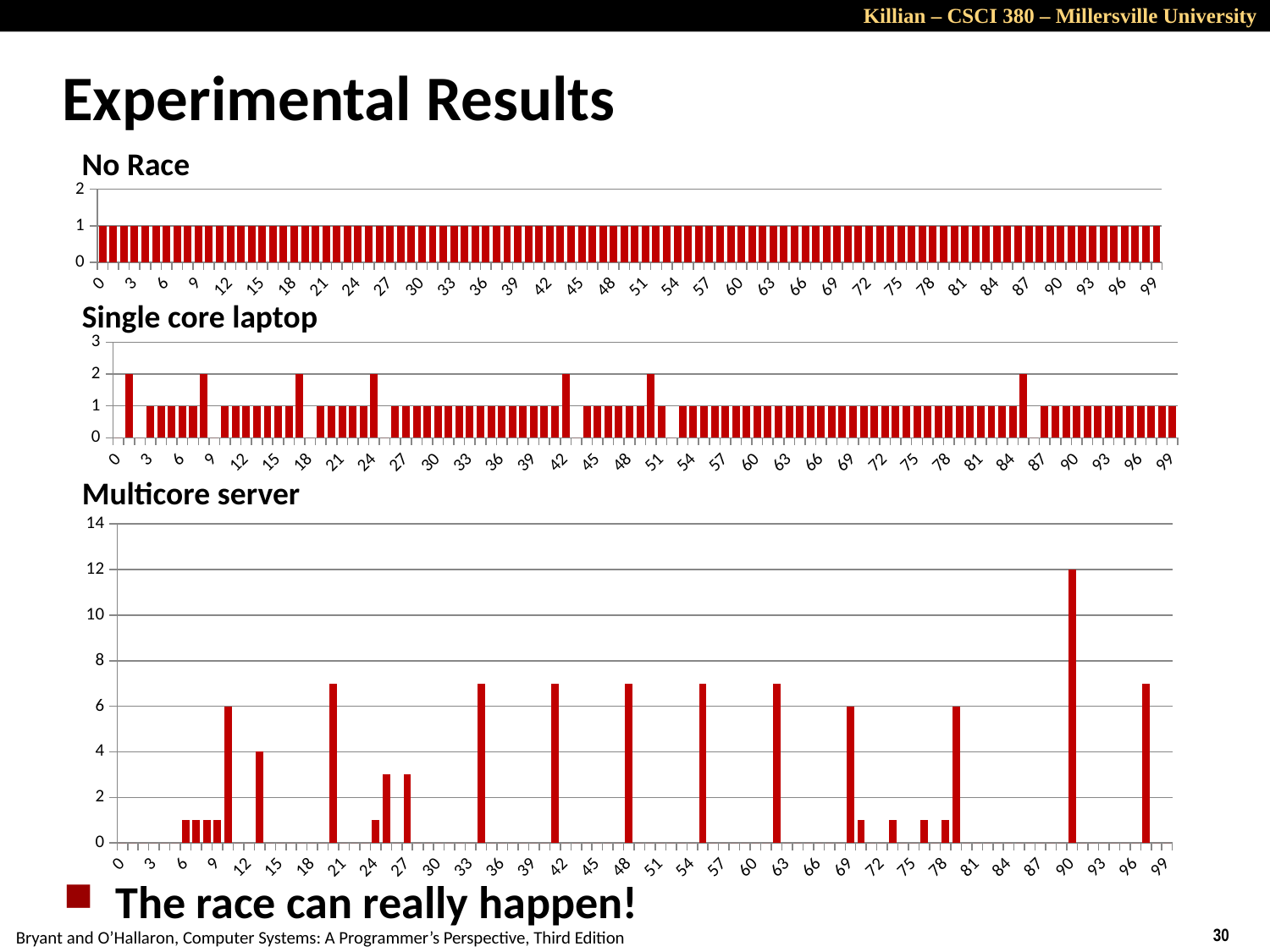
In the "Multicore server" chart, is the tallest bar greater or less than 10? greater In the "Multicore server" chart, what is the highest value reached by any bar? 12 In the "No Race" chart, what is the highest value on the y axis? 2 What is the title of the top chart on the slide? No Race In the "Multicore server" chart, what is the top value shown on the y axis? 14 What is the last label on the x axis of the "Multicore server" chart? 99 In the "Multicore server" chart, is the bar near x = 21 greater or less than 8? less In the "Single core laptop" chart, what is the highest value reached by any bar? 2 How many charts are shown on the slide? 3 What kind of chart is used for the "Multicore server" data? bar chart Which chart has the taller maximum bar, "Single core laptop" or "Multicore server"? Multicore server In the "No Race" chart, what value do all the bars reach? 1